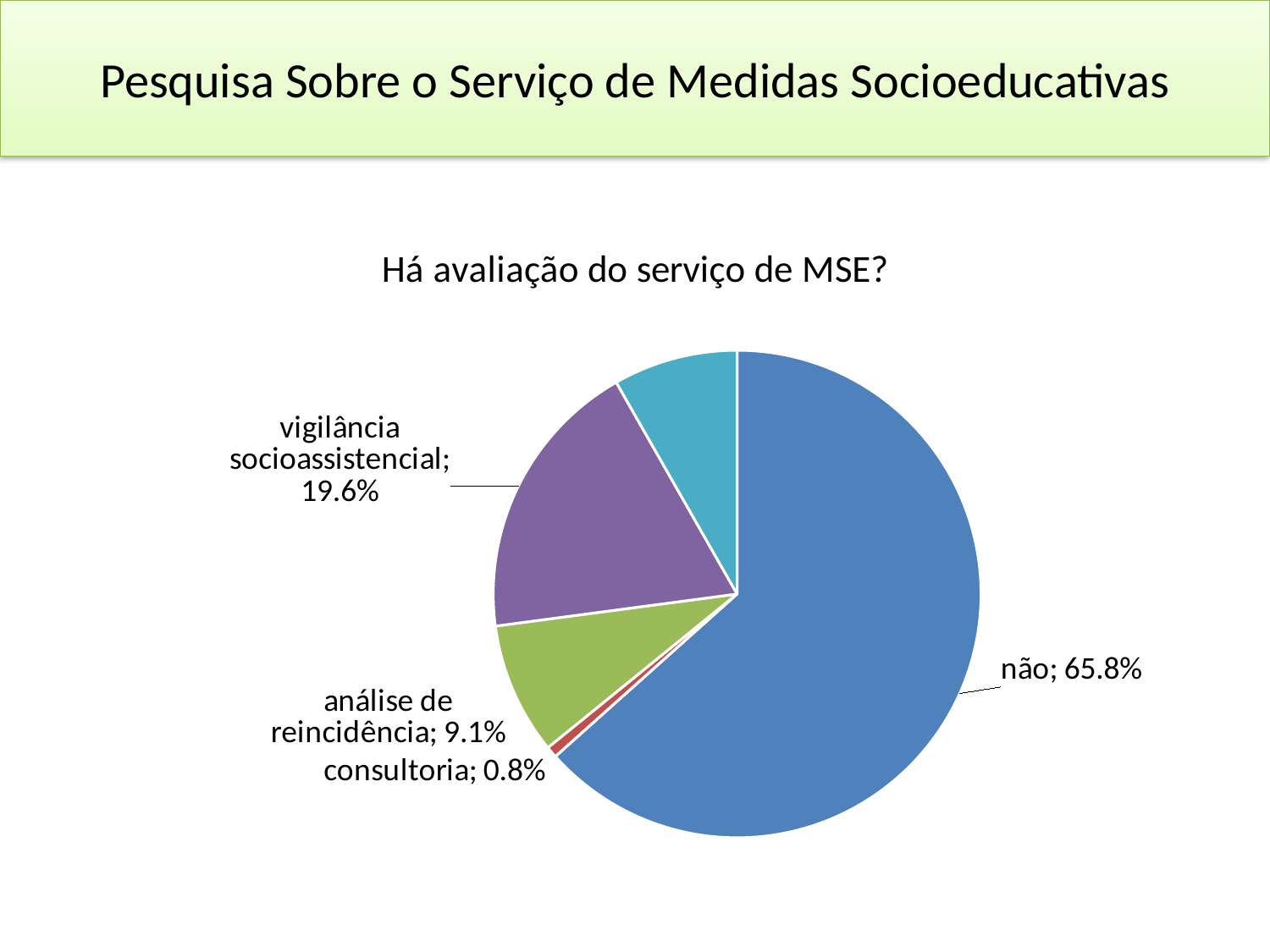
Which slice of the pie chart is the largest? não How many percentage points larger is "não" than "vigilância socioassistencial"? 46.2% What type of chart is shown on the slide? pie chart What is the title of the chart? Há avaliação do serviço de MSE? What is the value shown for "análise de reincidência"? 9.1% Which slice of the pie chart is the smallest? consultoria Which is larger, "análise de reincidência" or "vigilância socioassistencial"? vigilância socioassistencial What is the difference between "vigilância socioassistencial" and "análise de reincidência"? 10.5% How many slices does the pie chart have? 5 What share does "vigilância socioassistencial" have in the pie chart? 19.6% What percentage is shown for "consultoria"? 0.8% What percentage of the pie is labelled "não"? 65.8%